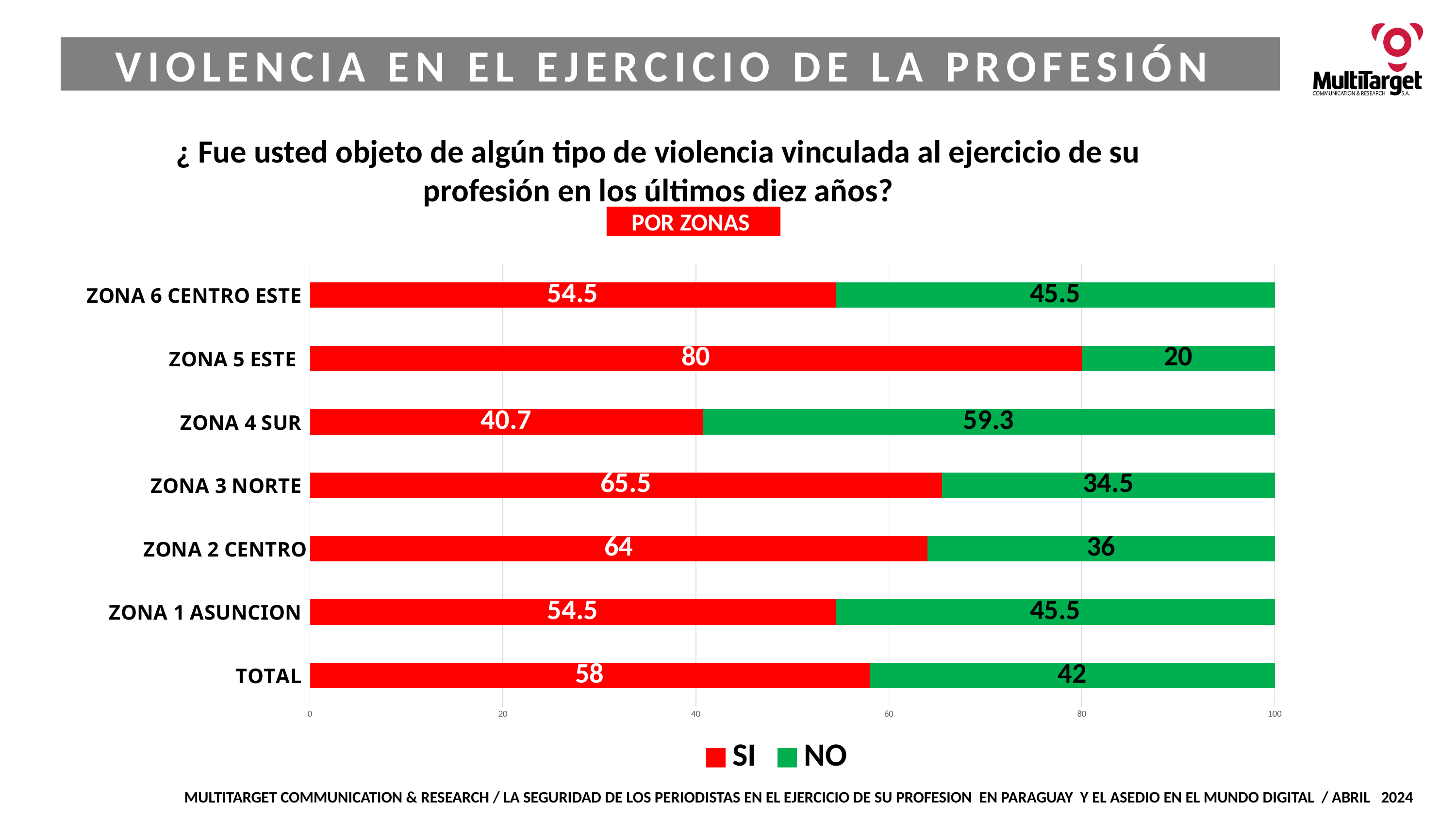
What is the total of the stacked bar for ZONA 6 CENTRO ESTE? 100 What is the SI value for ZONA 5 ESTE? 80 Which zone has the highest SI value? ZONA 5 ESTE How many categories (bars) are shown on the chart? 7 Which zone has the lowest SI value? ZONA 4 SUR How many series does the legend list? 2 What is the NO value for ZONA 4 SUR? 59.3 What kind of chart is shown on the slide? Stacked bar chart What is the difference between the SI values for ZONA 5 ESTE and ZONA 4 SUR? 39.3 Which is larger, the SI value for ZONA 3 NORTE or for ZONA 2 CENTRO? ZONA 3 NORTE What is the SI value for TOTAL? 58 Is the NO value for ZONA 5 ESTE greater or less than 40? less